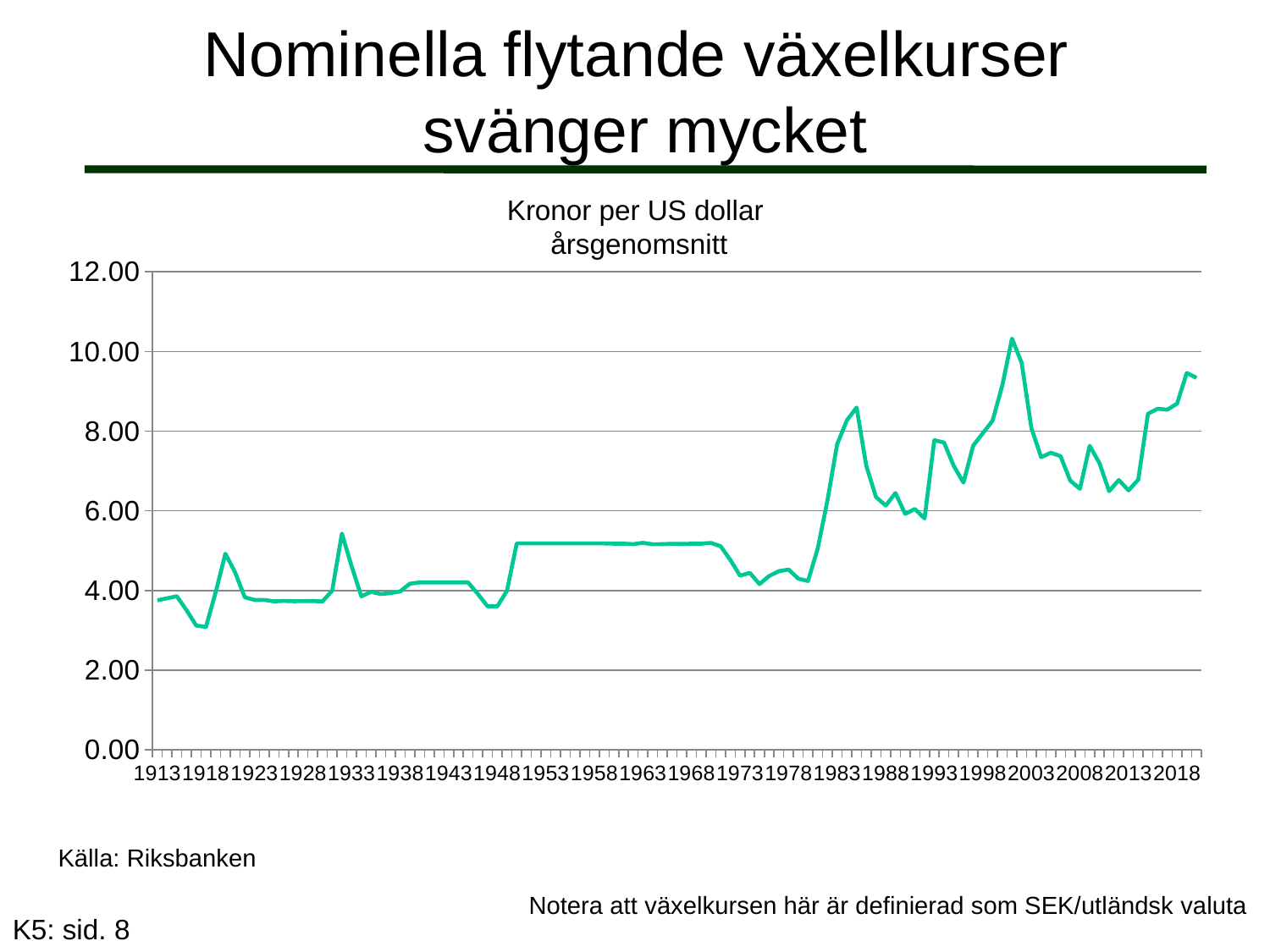
Does the exchange rate rise or fall between 1978 and 1983? rise What is the title of the chart? Kronor per US dollar årsgenomsnitt Is the value for 1958 greater or less than 4.00? greater Is the value for 1973 greater or less than 6.00? less Is the value for 1983 greater or less than 6.00? greater Which year has the larger value, 1913 or 2018? 2018 How many lines are plotted in the chart? 1 According to the slide, what is the source of the chart data? Riksbanken What kind of chart is shown on the slide? Line chart Which year has the larger value, 1973 or 1983? 1983